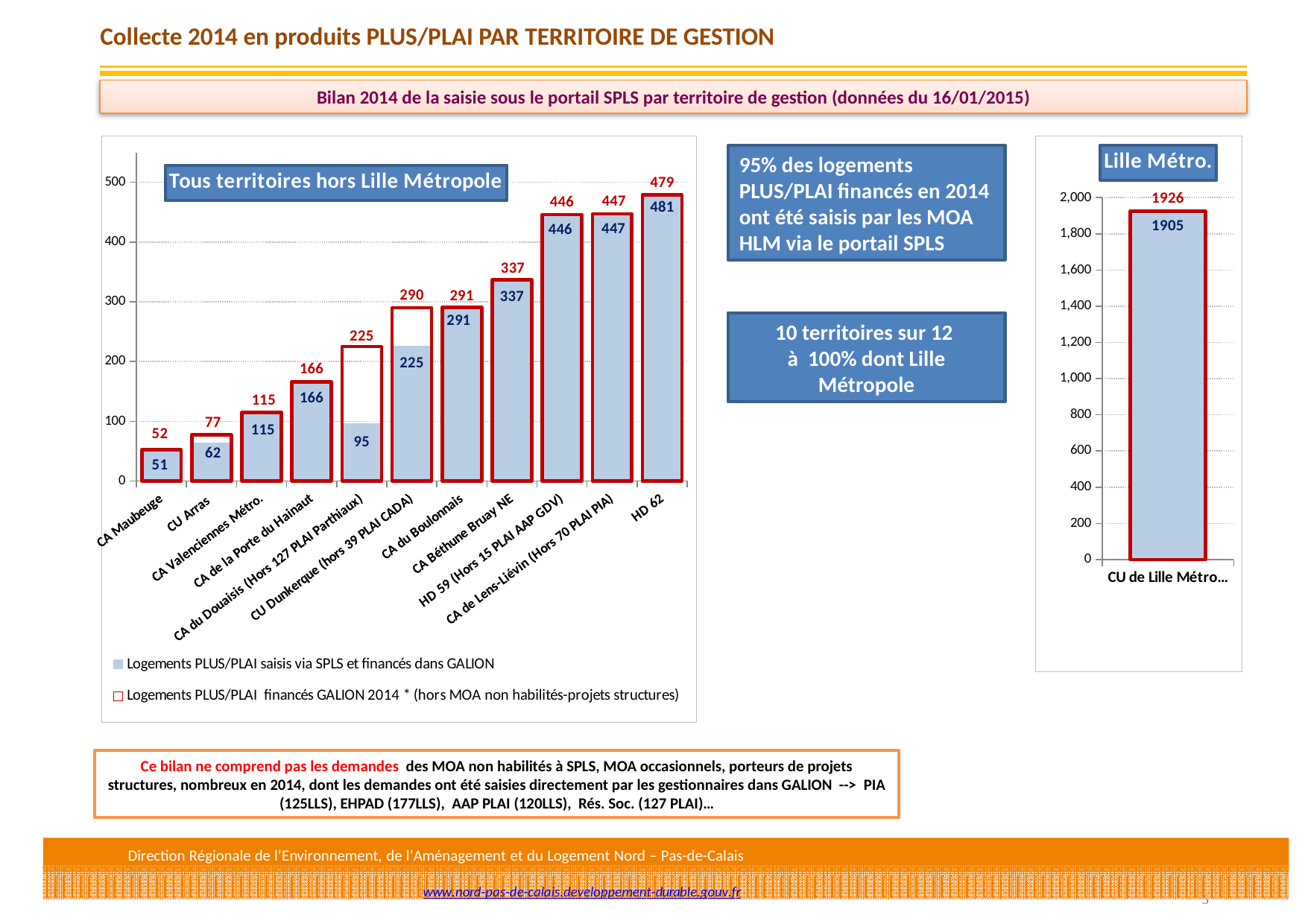
In the chart titled 'Tous territoires hors Lille Métropole', which territory has the highest value of 'Logements PLUS/PLAI saisis via SPLS et financés dans GALION'? HD 62 In the chart titled 'Lille Métro.', what is the value of 'Logements PLUS/PLAI saisis via SPLS et financés dans GALION' for CU de Lille Métro...? 1905 How many series does the legend of the chart titled 'Tous territoires hors Lille Métropole' list? 2 In the chart titled 'Tous territoires hors Lille Métropole', what is the difference between 'Logements PLUS/PLAI financés GALION 2014' and 'Logements PLUS/PLAI saisis via SPLS et financés dans GALION' for CU Dunkerque (hors 39 PLAI CADA)? 65 In the chart titled 'Tous territoires hors Lille Métropole', do the values of 'Logements PLUS/PLAI financés GALION 2014' rise or fall from left to right along the x axis? Rise In the chart titled 'Tous territoires hors Lille Métropole', what is the value of 'Logements PLUS/PLAI financés GALION 2014' for CU Arras? 77 In the chart titled 'Tous territoires hors Lille Métropole', what is the value of 'Logements PLUS/PLAI saisis via SPLS et financés dans GALION' for CA Béthune Bruay NE? 337 In the chart titled 'Tous territoires hors Lille Métropole', which territory has the lowest value of 'Logements PLUS/PLAI financés GALION 2014'? CA Maubeuge In the chart titled 'Tous territoires hors Lille Métropole', what is the value of 'Logements PLUS/PLAI saisis via SPLS et financés dans GALION' for CA du Douaisis (Hors 127 PLAI Parthiaux)? 95 What kind of chart is the chart titled 'Lille Métro.'? Bar chart In the chart titled 'Tous territoires hors Lille Métropole', which is larger for CA du Douaisis (Hors 127 PLAI Parthiaux): 'Logements PLUS/PLAI financés GALION 2014' or 'Logements PLUS/PLAI saisis via SPLS et financés dans GALION'? Logements PLUS/PLAI financés GALION 2014 How many territories are shown on the x axis of the chart titled 'Tous territoires hors Lille Métropole'? 11